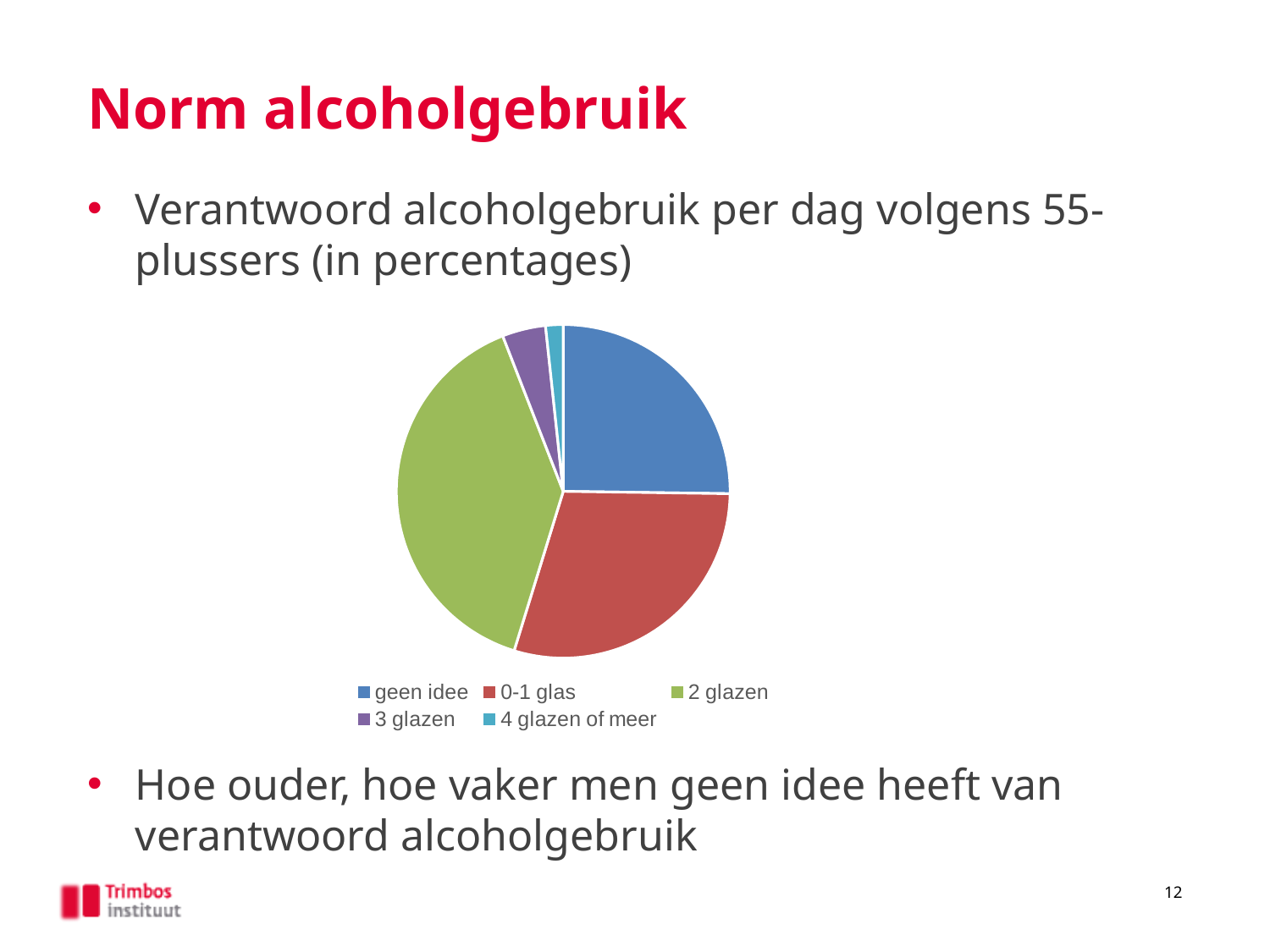
Which slice is larger in the pie chart: 0-1 glas or 3 glazen? 0-1 glas Which category has the largest slice in the pie chart? 2 glazen How many slices does the pie chart have? 5 Which category in the pie chart is shown in green? 2 glazen What kind of chart is shown on the slide? pie chart Which slice is larger in the pie chart: 3 glazen or 4 glazen of meer? 3 glazen Which category has the smallest slice in the pie chart? 4 glazen of meer Which slice is larger in the pie chart: 0-1 glas or geen idee? 0-1 glas How many entries does the legend of the pie chart list? 5 What colour is the slice for geen idee in the pie chart? blue